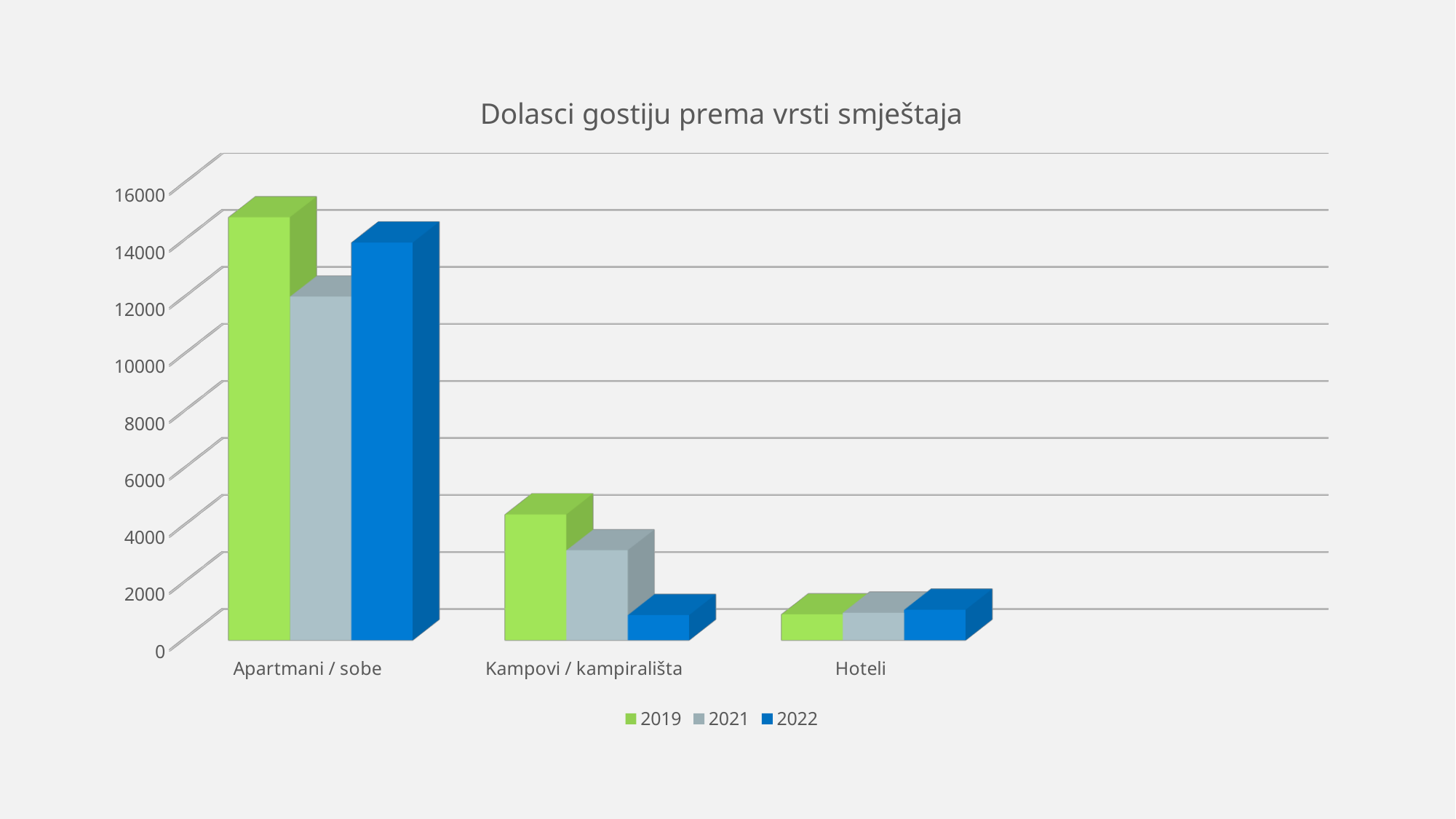
Is the 2019 value for Apartmani / sobe greater or less than 14000? greater Is the 2022 value for Kampovi / kampirališta greater or less than 2000? less How many categories are shown on the x axis? 3 For Kampovi / kampirališta, which is larger: the 2021 value or the 2022 value? 2021 How many series does the legend list? 3 Which category has the lowest value for 2019? Hoteli Which colour represents the 2022 series in the legend? blue What kind of chart is shown on the slide? bar chart Is the 2021 value for Kampovi / kampirališta greater or less than 4000? less Which category has the highest value for 2019? Apartmani / sobe For Apartmani / sobe, which is larger: the 2019 value or the 2021 value? 2019 What is the title of the chart? Dolasci gostiju prema vrsti smještaja